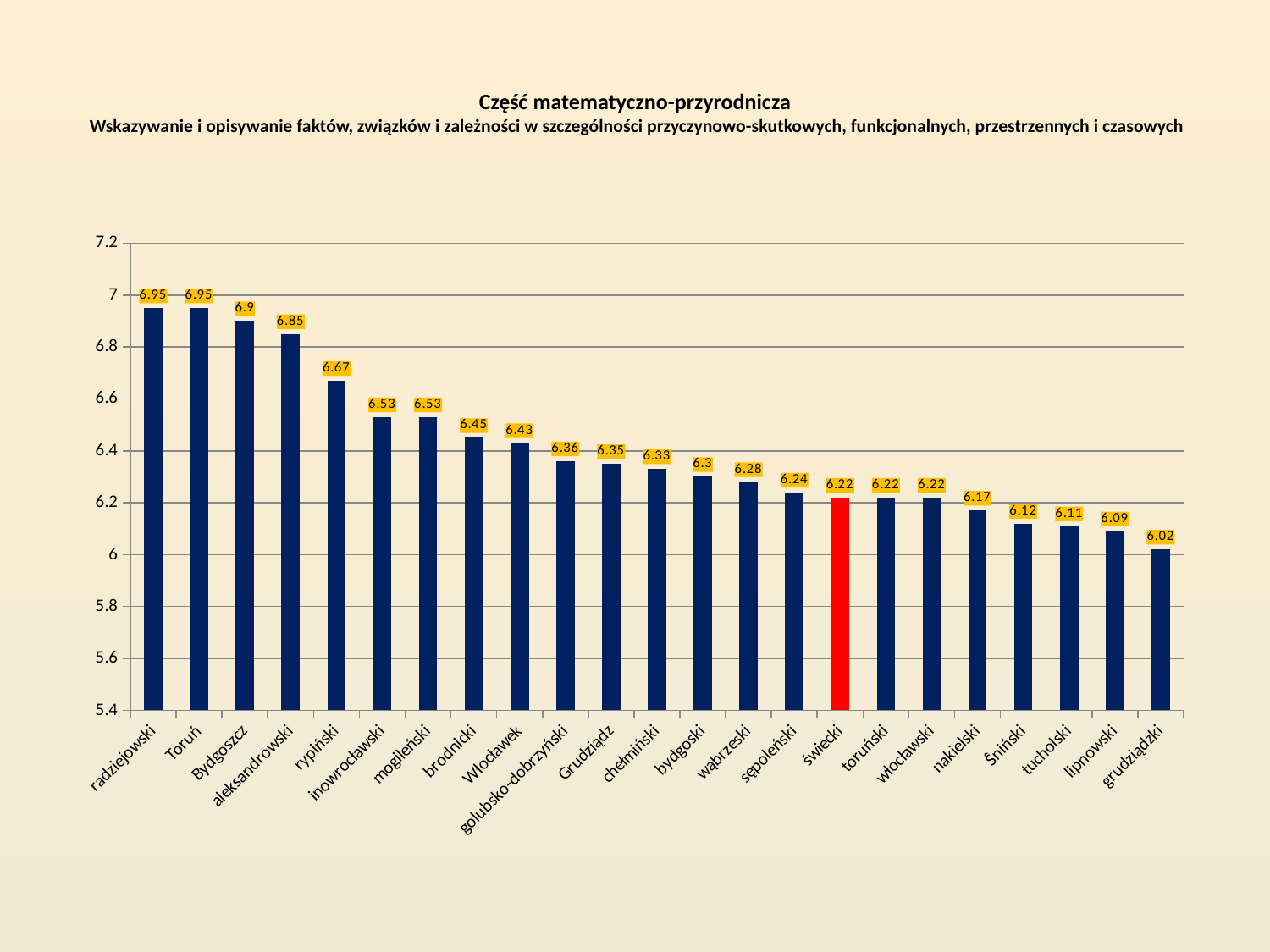
What is the difference between the values for aleksandrowski and brodnicki? 0.4 What is the value for nakielski? 6.17 Do the values rise or fall from left to right along the x axis? fall What is the value for rypiński? 6.67 What kind of chart is shown on the slide? bar chart What is the value for Włocławek? 6.43 Which is larger, the value for Grudziądz or the value for bydgoski? Grudziądz What is the value for the red bar (świecki)? 6.22 How many categories are shown on the x axis? 23 What is the difference between the values for Bydgoszcz and grudziądzki? 0.88 Which category has the lowest value? grudziądzki Is the value for lipnowski greater or less than 6.2? less